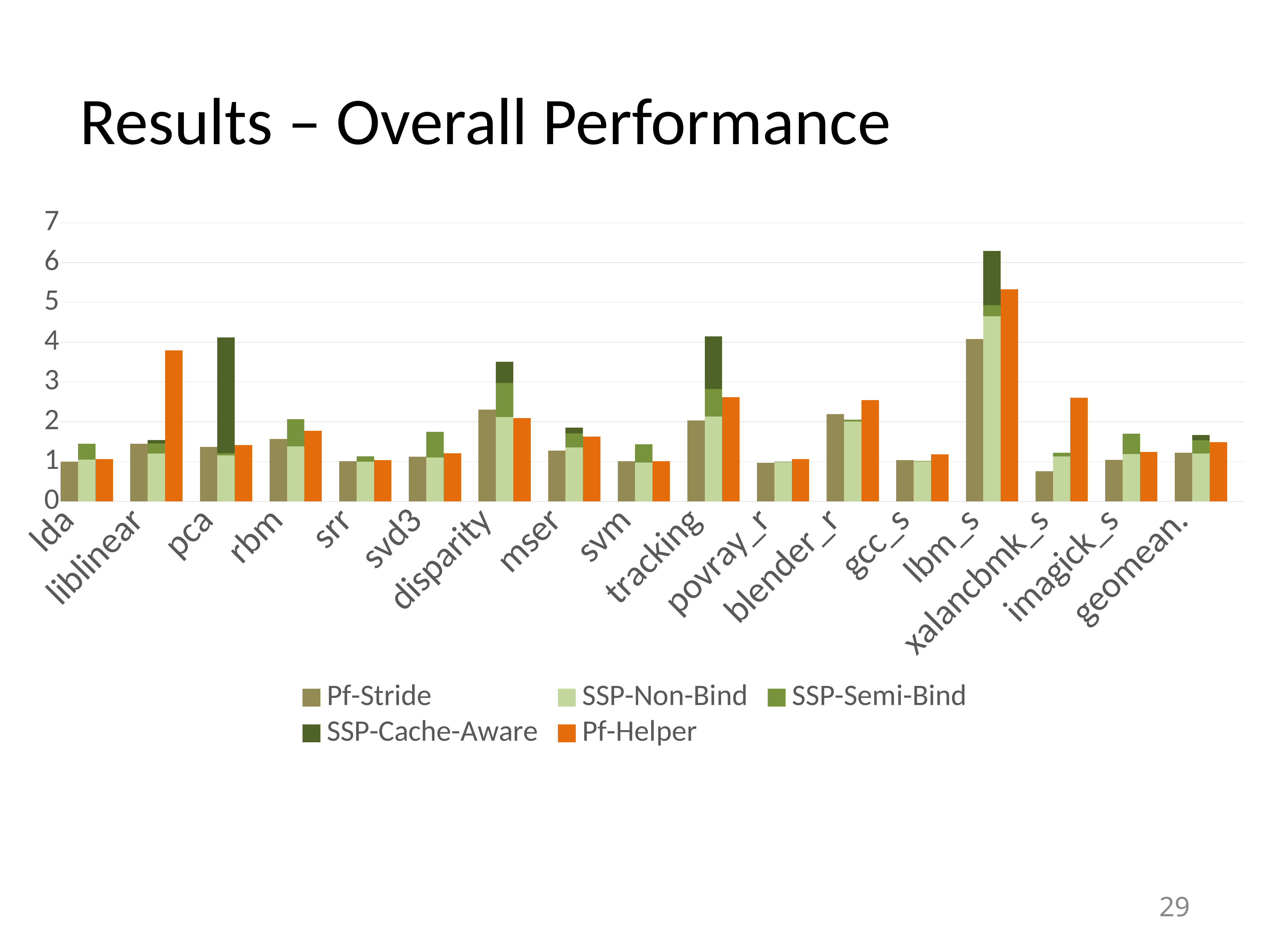
How many categories are shown along the x axis? 17 Which category has the lowest Pf-Stride bar? xalancbmk_s Is the Pf-Helper value for liblinear greater or less than 3? greater Which category has the highest Pf-Helper bar? lbm_s Is the Pf-Helper value for lbm_s greater or less than 5? greater What kind of chart is shown on the slide? bar chart Is the Pf-Stride value for xalancbmk_s greater or less than 1? less For liblinear, which is larger: the Pf-Stride value or the Pf-Helper value? Pf-Helper How many series does the legend list? 5